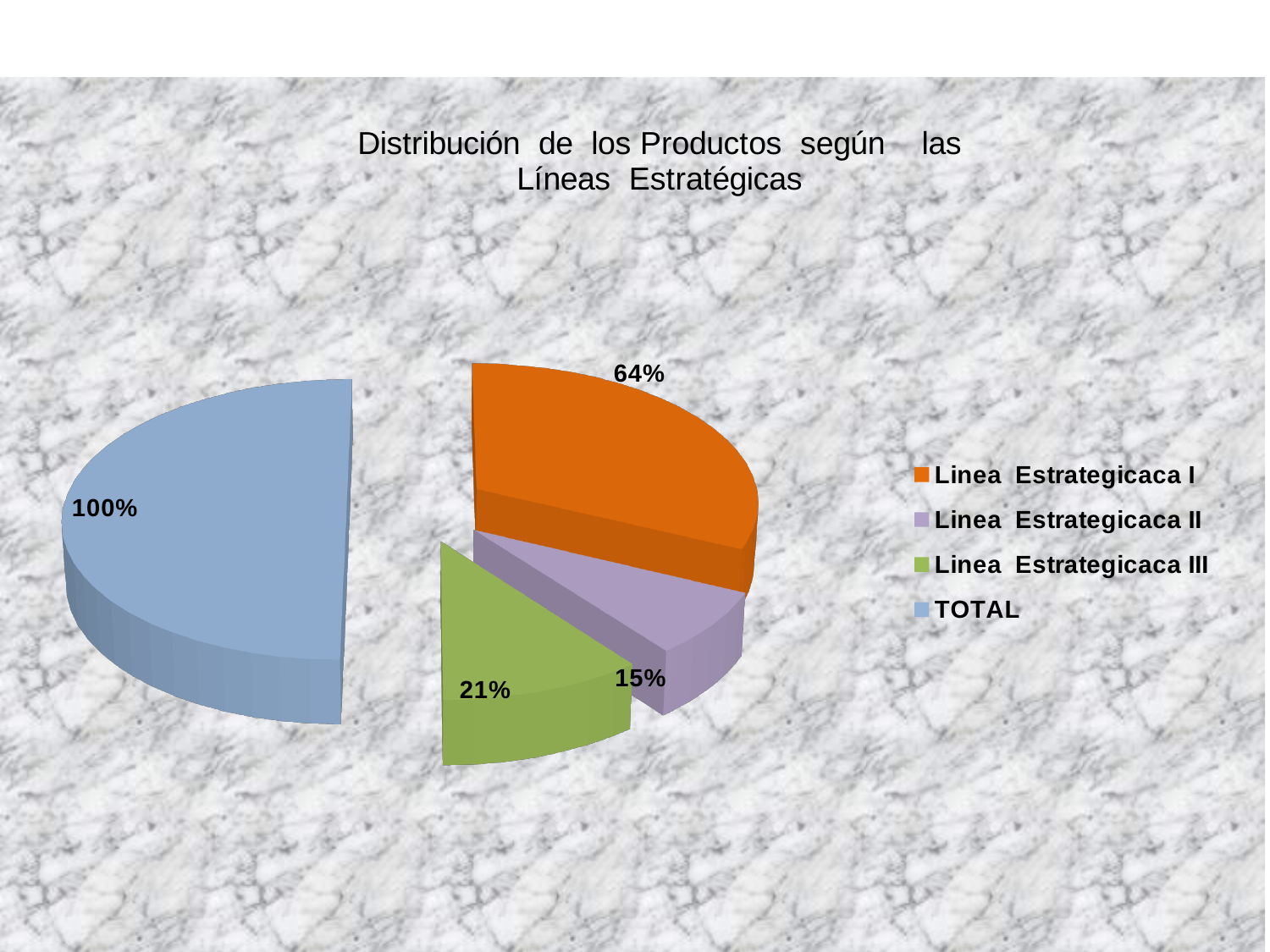
What colour is the TOTAL slice in the pie chart? Blue What value is shown for the TOTAL slice? 100% What is the difference between the values for Linea Estrategicaca III and Linea Estrategicaca II? 6% Which slice has the lowest value? Linea Estrategicaca II Among the three Linea Estrategicaca slices, which has the highest value? Linea Estrategicaca I What is the difference between the values for Linea Estrategicaca I and Linea Estrategicaca II? 49% What value is shown for Linea Estrategicaca II? 15% Which is larger, the value for Linea Estrategicaca III or Linea Estrategicaca II? Linea Estrategicaca III How many slices does the pie chart have? 4 What value is shown for Linea Estrategicaca III? 21% What value is shown for Linea Estrategicaca I? 64% What kind of chart is shown on the slide? Pie chart